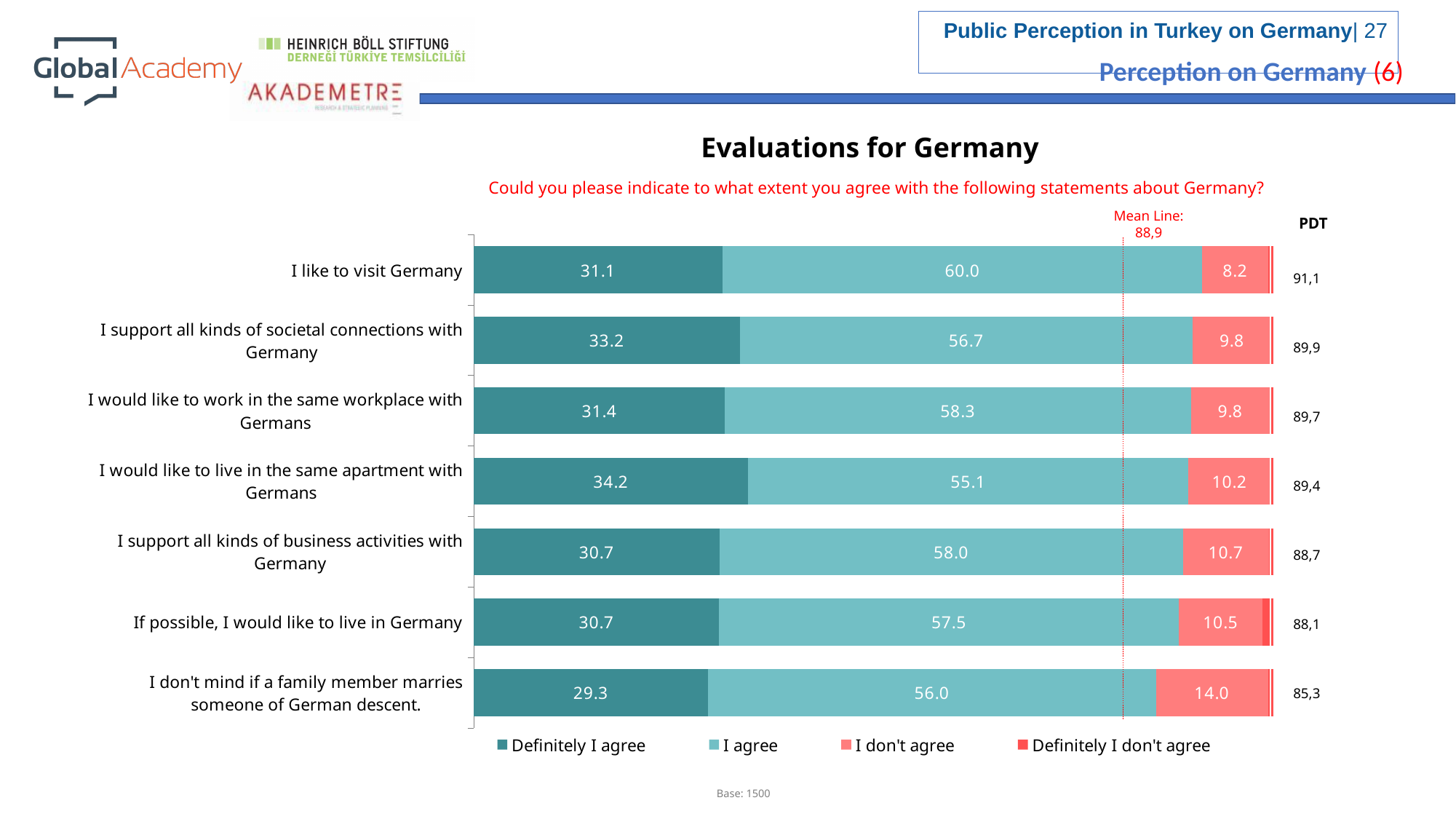
Which statement has the lowest "Definitely I agree" value? I don't mind if a family member marries someone of German descent. How many series does the legend list? 4 What value is given for the Mean Line on the chart? 88,9 Which has the larger "Definitely I agree" value: "I support all kinds of societal connections with Germany" or "I support all kinds of business activities with Germany"? I support all kinds of societal connections with Germany What is the "I don't agree" value for "I don't mind if a family member marries someone of German descent."? 14.0 Which statement has the highest "I don't agree" value? I don't mind if a family member marries someone of German descent. Which statement has the highest "Definitely I agree" value? I would like to live in the same apartment with Germans What is the "I agree" value for "I would like to work in the same workplace with Germans"? 58.3 What is the difference between the "I agree" values for "I like to visit Germany" and "I don't mind if a family member marries someone of German descent."? 4.0 What is the "Definitely I agree" value for "I like to visit Germany"? 31.1 What is the PDT value shown for "I like to visit Germany"? 91,1 How many statements are shown in the chart? 7